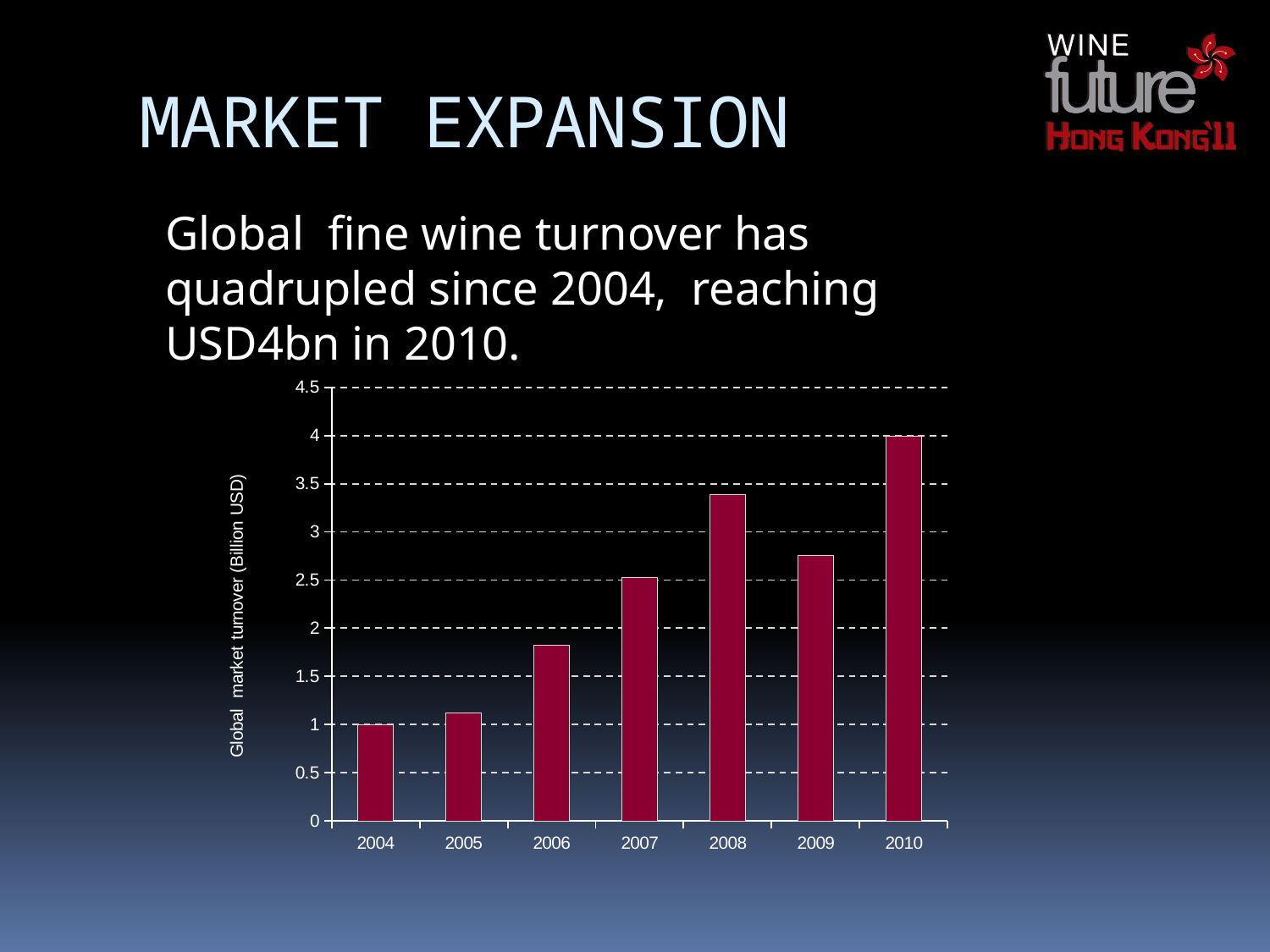
What is the label on the y axis of the chart? Global market turnover (Billion USD) What kind of chart is shown on the slide? bar chart Is the value for 2008 greater or less than 3? greater What is the global market turnover (Billion USD) for 2004 in the chart? 1 What is the global market turnover (Billion USD) for 2010 in the chart? 4 How many years are shown on the x axis of the chart? 7 Which year has the lowest global market turnover in the chart? 2004 Which year has the highest global market turnover in the chart? 2010 Is the value for 2005 greater or less than 1.5? less Is the value for 2006 greater or less than 2? less Which year has the larger global market turnover, 2008 or 2009? 2008